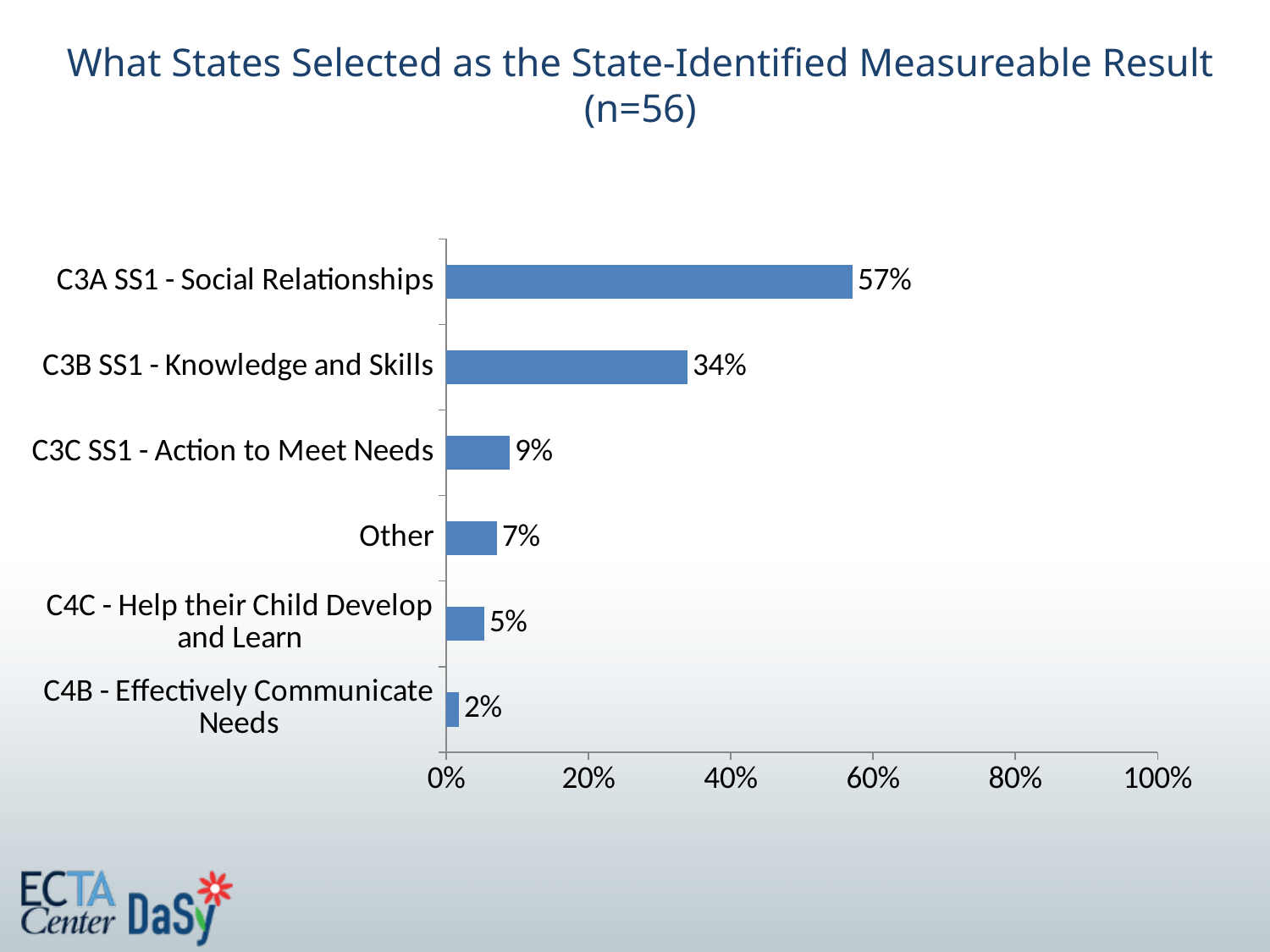
What is the title of the chart? What States Selected as the State-Identified Measureable Result (n=56) What kind of chart is shown on the slide? bar chart What percentage is shown for C4C - Help their Child Develop and Learn? 5% What percentage of states selected C3A SS1 - Social Relationships? 57% What is the value for C3B SS1 - Knowledge and Skills? 34% Is the value for C3B SS1 - Knowledge and Skills greater or less than 40%? less Which category has the lowest value? C4B - Effectively Communicate Needs What is the difference between the values for C3A SS1 - Social Relationships and C3B SS1 - Knowledge and Skills? 23% How many categories are shown in the chart? 6 What is the maximum value shown on the horizontal axis? 100% Which category has the highest value? C3A SS1 - Social Relationships Which is larger, the value for C3C SS1 - Action to Meet Needs or the value for Other? C3C SS1 - Action to Meet Needs